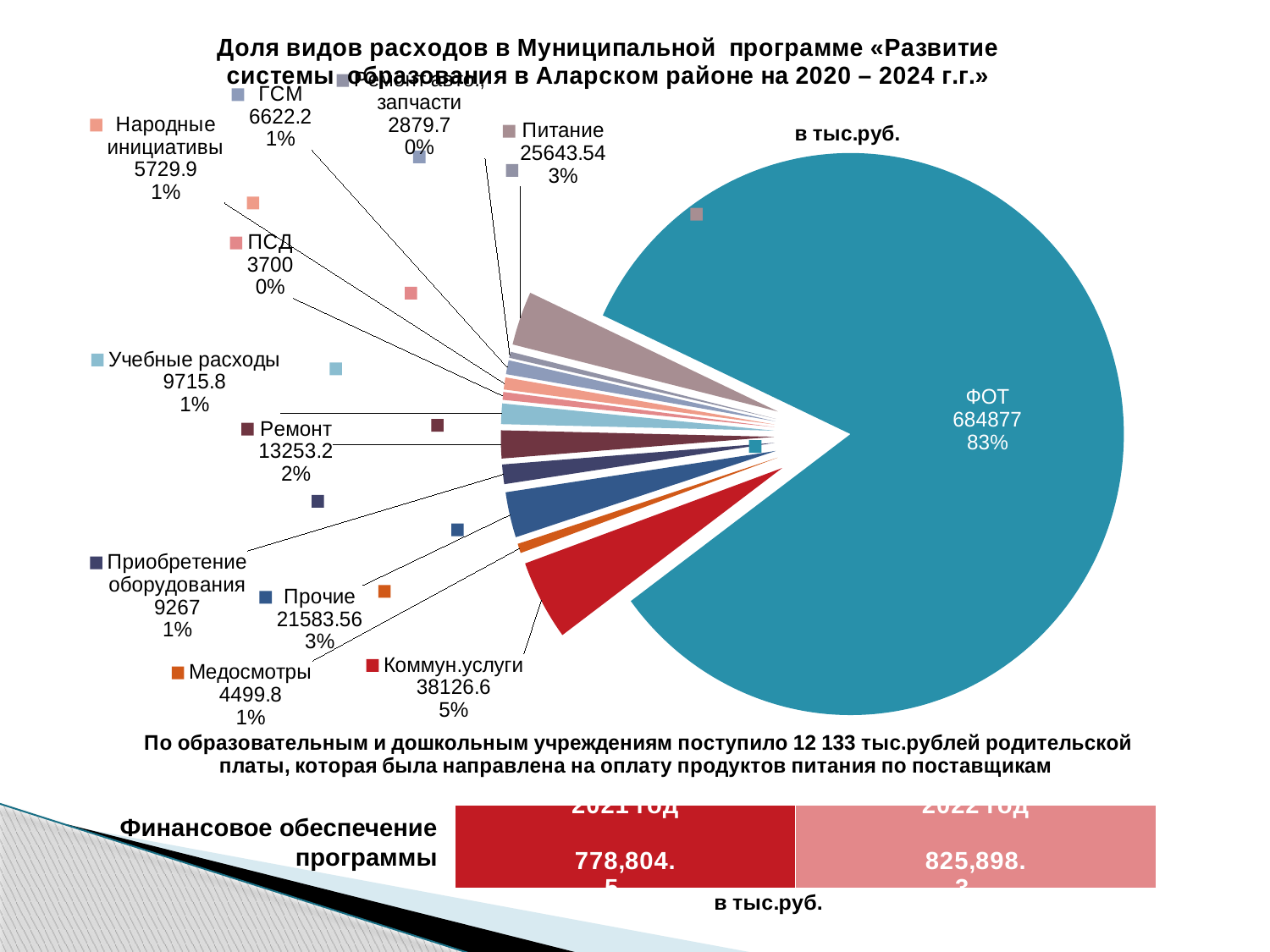
What share of the pie does ФОТ represent? 83% Which is larger, Коммун.услуги or Прочие? Коммун.услуги What is the difference between the values for Коммун.услуги and Питание? 12483.06 What kind of chart is shown on the slide? pie chart What is the value for Коммун.услуги? 38126.6 What share of the pie does Коммун.услуги represent? 5% What is the value for Питание? 25643.54 Which category has the largest slice of the pie? ФОТ How many slices does the pie chart have? 12 In what units are the values of the pie chart given? тыс.руб. What is the value for Ремонт? 13253.2 What is the value for ФОТ? 684877